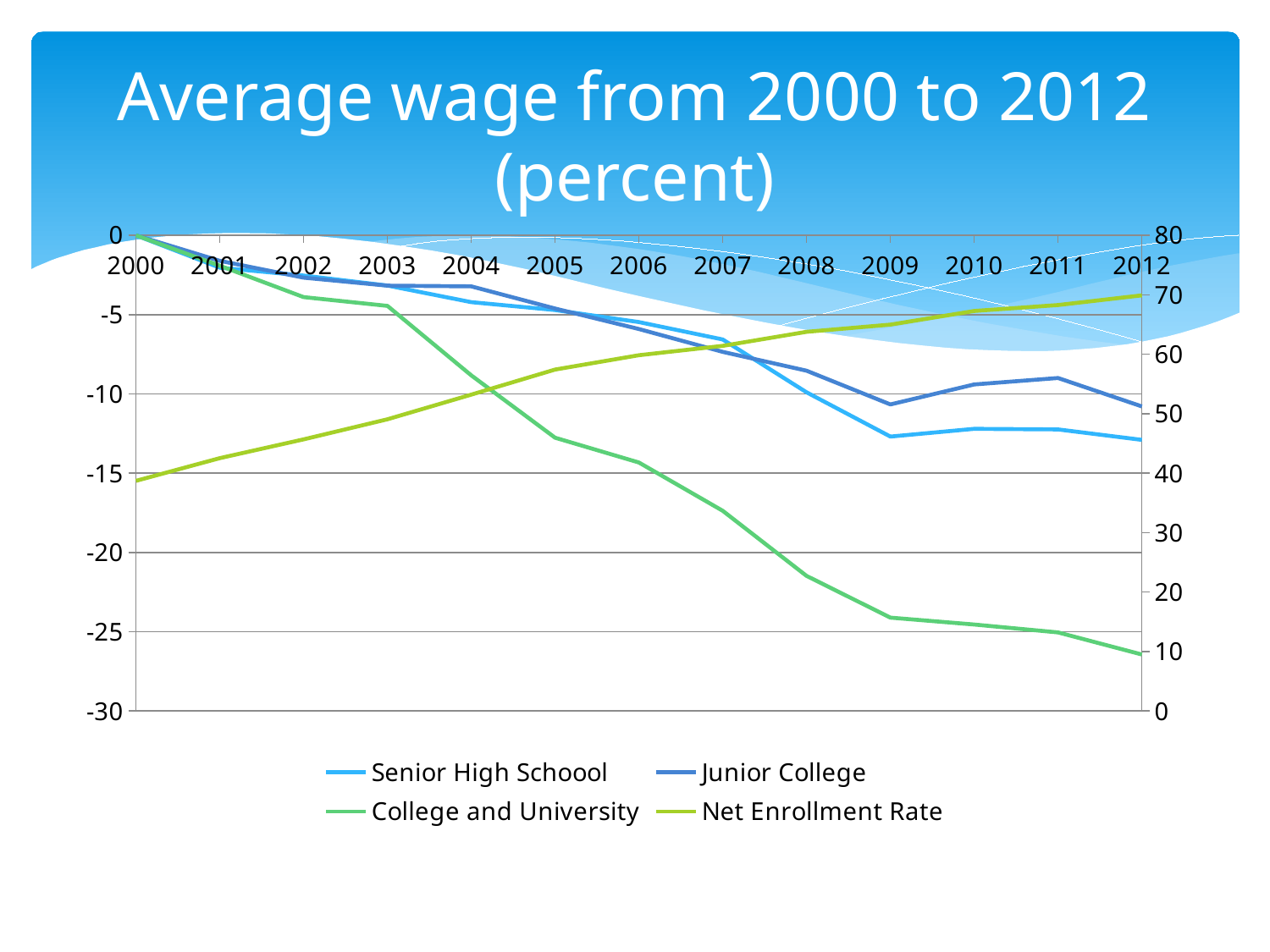
Is the value for College and University in 2012 greater or less than -25? less In 2012, which is higher: Senior High Schoool or Junior College? Junior College Is the value for Net Enrollment Rate in 2012 greater or less than 60 on the right axis? greater What is the title of the chart? Average wage from 2000 to 2012 (percent) Which series is shown in dark green in the legend? College and University What is the value for Senior High Schoool in 2000? 0 How many years are plotted along the x axis? 13 What kind of chart is shown on the slide? line chart How many series does the legend list? 4 Is the value for Senior High Schoool in 2012 greater or less than -10? less Does the College and University line rise or fall from 2000 to 2012? fall Does the Net Enrollment Rate line rise or fall from 2000 to 2012? rise